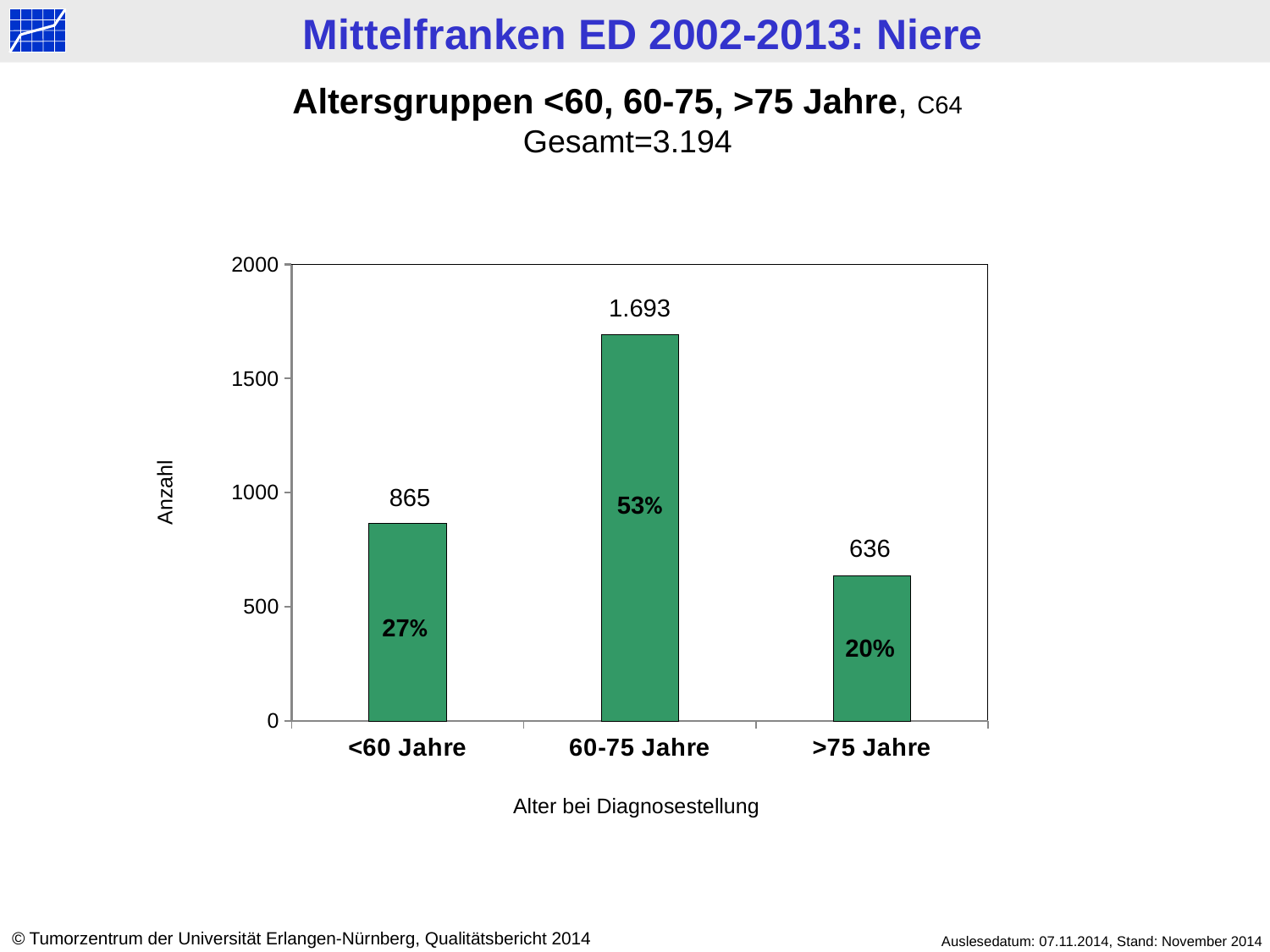
What percentage is printed on the bar for the 60-75 Jahre age group? 53% Is the value for 60-75 Jahre greater or less than 1500? greater Which is larger, the value for <60 Jahre or the value for >75 Jahre? <60 Jahre What is the value for the <60 Jahre age group? 865 What is the value for the >75 Jahre age group? 636 How many age groups are shown in the chart? 3 What is the label of the x axis? Alter bei Diagnosestellung Which age group has the highest value? 60-75 Jahre What is the value for the 60-75 Jahre age group? 1.693 What is the difference between the values for 60-75 Jahre and <60 Jahre? 828 Which age group has the lowest value? >75 Jahre What kind of chart is shown on the slide? bar chart